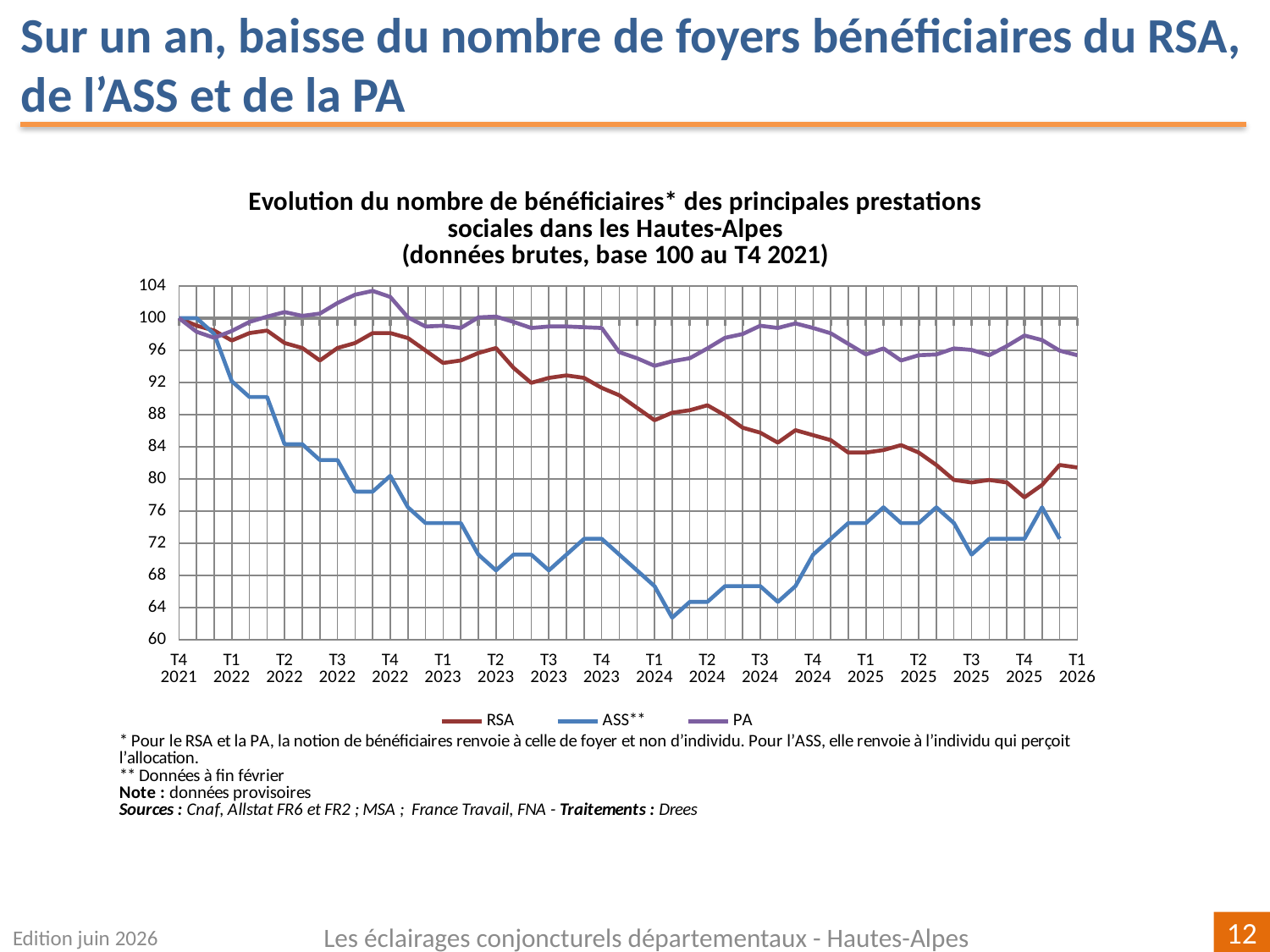
How many series does the legend list? 3 Which series is highest at T1 2026? PA Is the value for PA at T4 2022 greater or less than 100? greater What type of chart is shown on the slide? line chart Which series are listed in the legend? RSA, ASS**, PA How many quarters are labelled on the x axis? 18 What is the value of the RSA series at T4 2021? 100 Is the value for ASS** at T1 2024 greater or less than 68? less Which series reaches the lowest value on the chart? ASS** Is the value for RSA at T1 2025 greater or less than 80? greater Does the ASS** series overall rise or fall between T4 2021 and T1 2026? fall